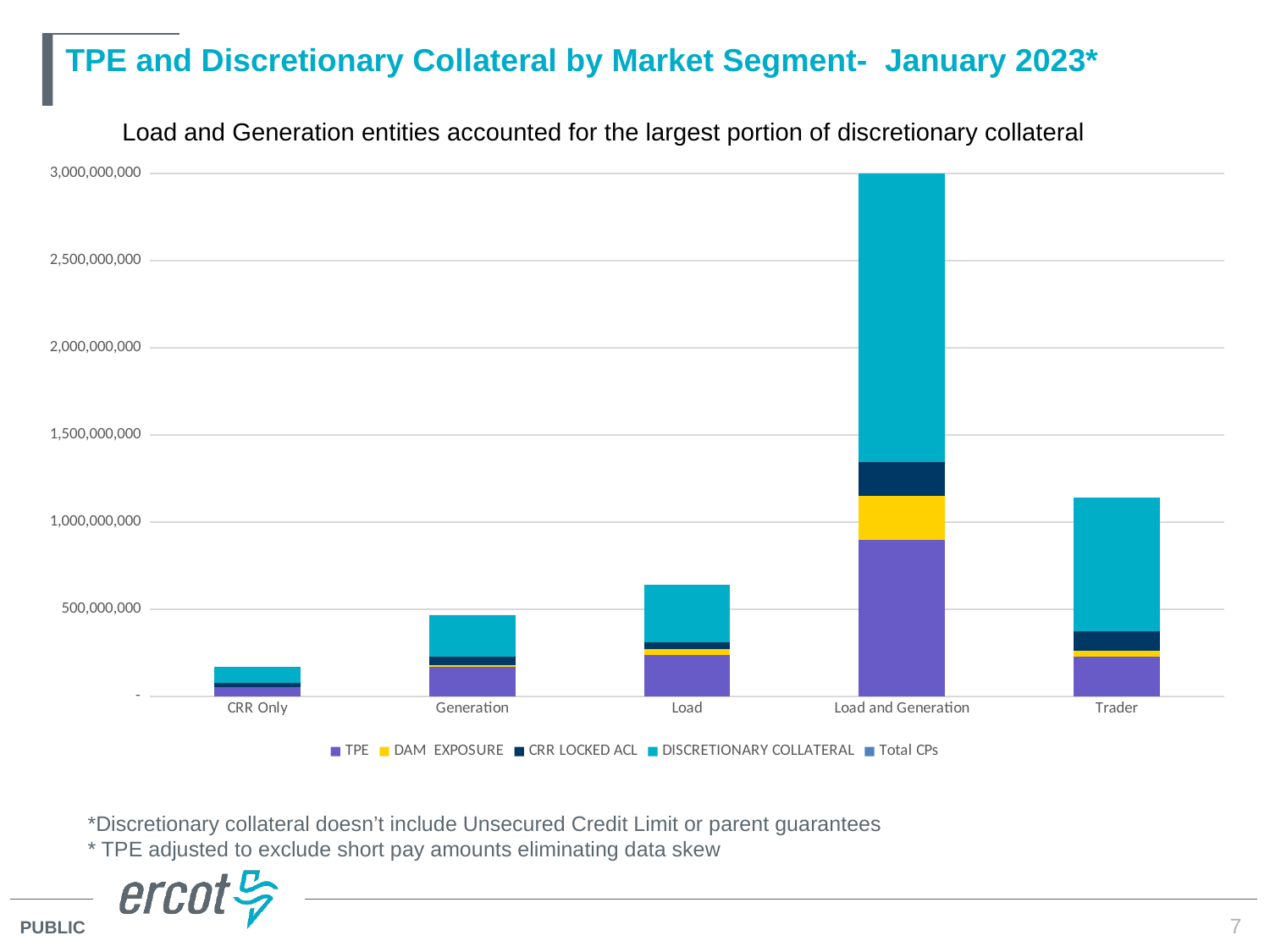
Which stacked bar is taller, Trader or Load? Trader Which market segment has the shortest stacked bar? CRR Only Is the total of the CRR Only bar greater or less than 500,000,000? less How many market segment categories are shown on the x axis? 5 What is the title of the slide containing the chart? TPE and Discretionary Collateral by Market Segment- January 2023* Which market segment has the tallest stacked bar? Load and Generation Is the total of the Load and Generation bar greater or less than 2,500,000,000? greater Which legend entry is shown in yellow? DAM EXPOSURE Is the total of the Trader bar greater or less than 1,000,000,000? greater Which stacked bar is taller, Generation or CRR Only? Generation What kind of chart is shown on the slide? Stacked bar chart How many series does the legend list? 5